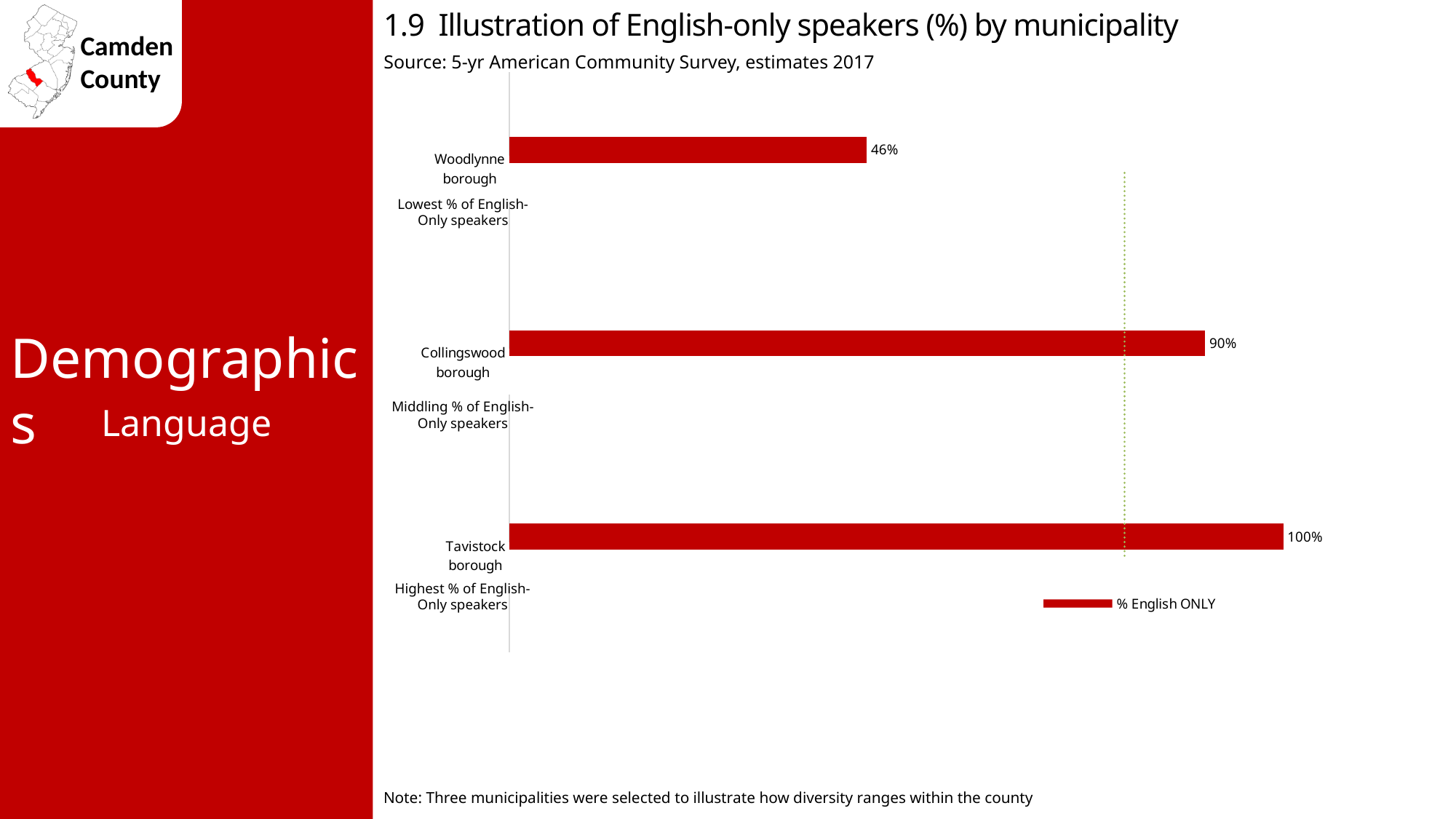
Which has a higher percentage of English-only speakers, Collingswood borough or Woodlynne borough? Collingswood borough What is the percentage of English-only speakers for Collingswood borough? 90% Which municipality has the highest percentage of English-only speakers? Tavistock borough How many series does the legend list? 1 What kind of chart is shown on the slide? Bar chart What is the difference in percentage points between Collingswood borough and Woodlynne borough? 44 What is the percentage of English-only speakers for Tavistock borough? 100% Which municipality has the lowest percentage of English-only speakers? Woodlynne borough What is the name of the series shown in the legend? % English ONLY How many municipalities are shown in the chart? 3 What is the difference in percentage points between Tavistock borough and Woodlynne borough? 54 What is the percentage of English-only speakers for Woodlynne borough? 46%